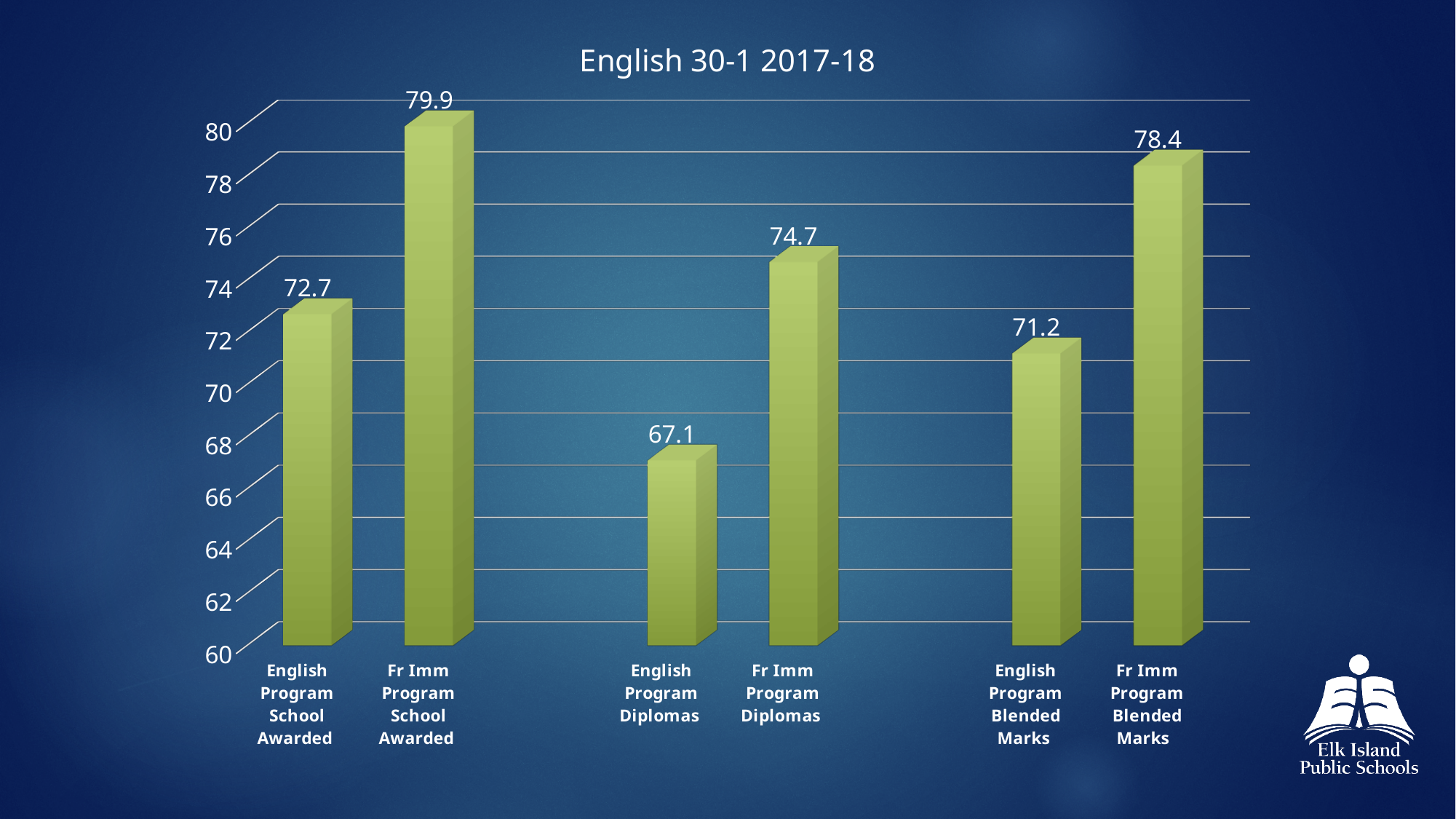
How many bars are shown in the chart? 6 What is the title of the chart? English 30-1 2017-18 Is the value for English Program Diplomas greater or less than 70? less Which category has the lowest value? English Program Diplomas What is the difference between Fr Imm Program Blended Marks and English Program Blended Marks? 7.2 What is the difference between Fr Imm Program School Awarded and English Program School Awarded? 7.2 Which is larger, Fr Imm Program Diplomas or English Program Diplomas? Fr Imm Program Diplomas What is the value for English Program School Awarded? 72.7 What is the value for English Program Blended Marks? 71.2 Which category has the highest value? Fr Imm Program School Awarded What kind of chart is shown on the slide? bar chart What is the value for Fr Imm Program Diplomas? 74.7